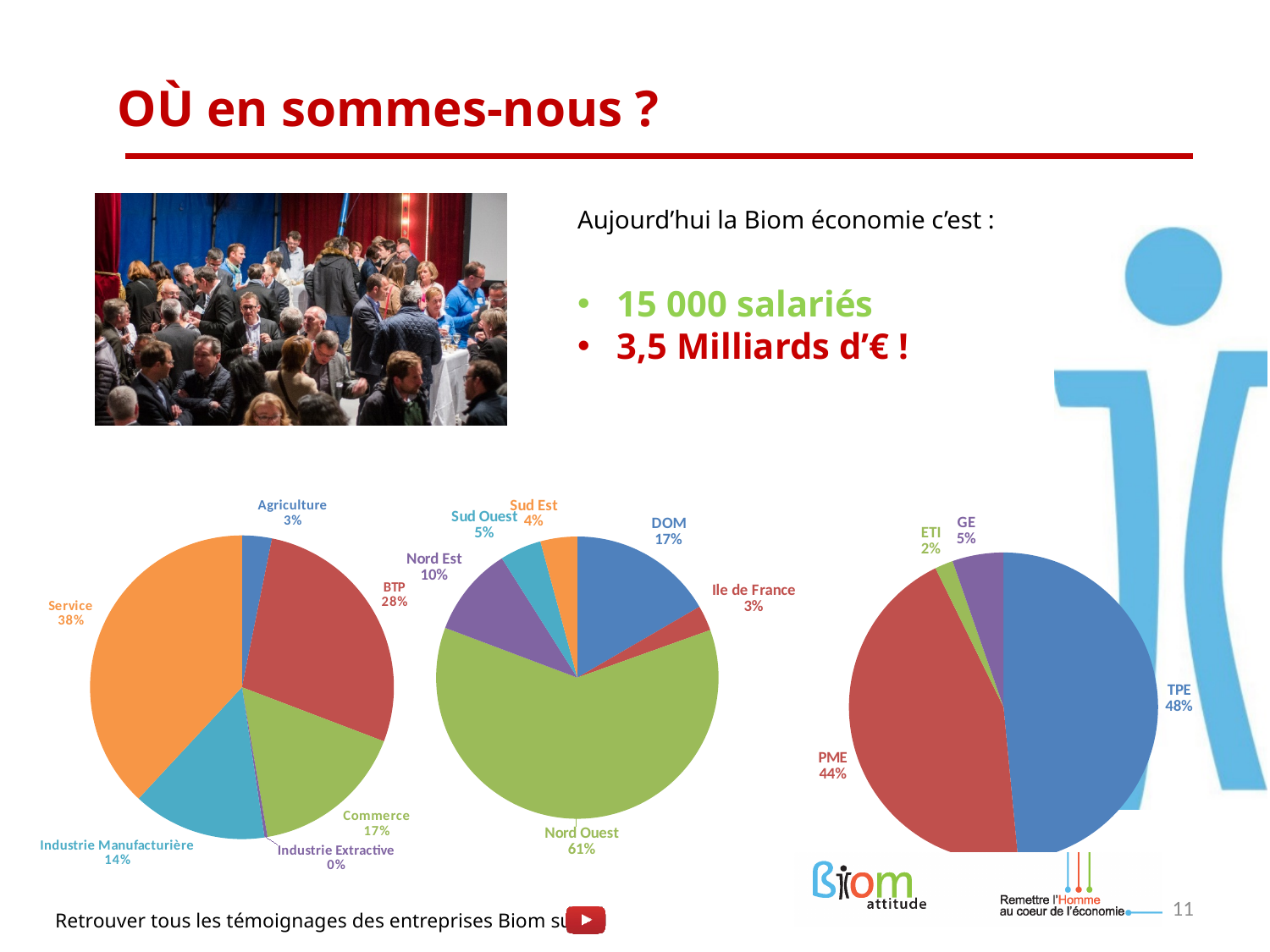
In the right pie chart, what share does PME have? 44% In the left pie chart, which sector has the smallest share? Industrie Extractive In the middle pie chart, what share does Nord Ouest have? 61% In the middle pie chart, which is larger, DOM or Nord Est? DOM In the left pie chart, what is the difference between the shares of BTP and Commerce? 11% In the middle pie chart, which region has the smallest share? Ile de France In the right pie chart, which category has the largest share? TPE What type of chart is the right chart on the slide? Pie chart In the left pie chart, which sector has the largest share? Service How many categories does the middle pie chart show? 6 How many categories does the left pie chart show? 6 In the left pie chart, what share does Service have? 38%